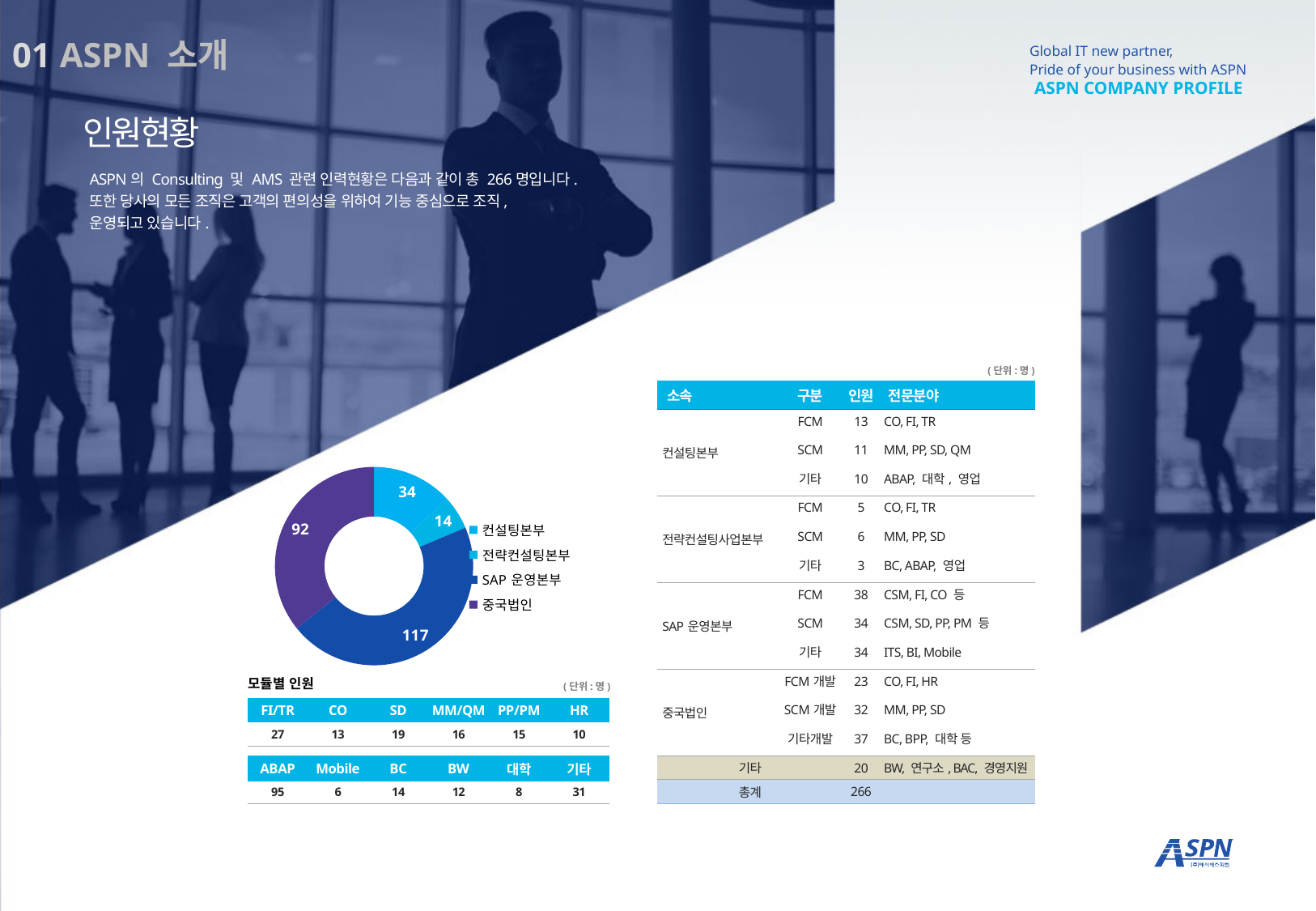
What is the difference between the values for SAP 운영본부 and 중국법인 in the doughnut chart? 25 In the doughnut chart, what is the value for 컨설팅본부? 34 How many categories does the doughnut chart show? 4 In the doughnut chart, what is the value for 전략컨설팅본부? 14 In the doughnut chart, what is the value for SAP 운영본부? 117 Which category has the smallest segment in the doughnut chart? 전략컨설팅본부 What kind of chart is shown on the slide? doughnut chart What is the difference between the values for 컨설팅본부 and 전략컨설팅본부 in the doughnut chart? 20 Which is larger in the doughnut chart, 중국법인 or 컨설팅본부? 중국법인 In the doughnut chart, what is the value for 중국법인? 92 How many entries does the legend of the doughnut chart list? 4 Which category has the largest segment in the doughnut chart? SAP 운영본부